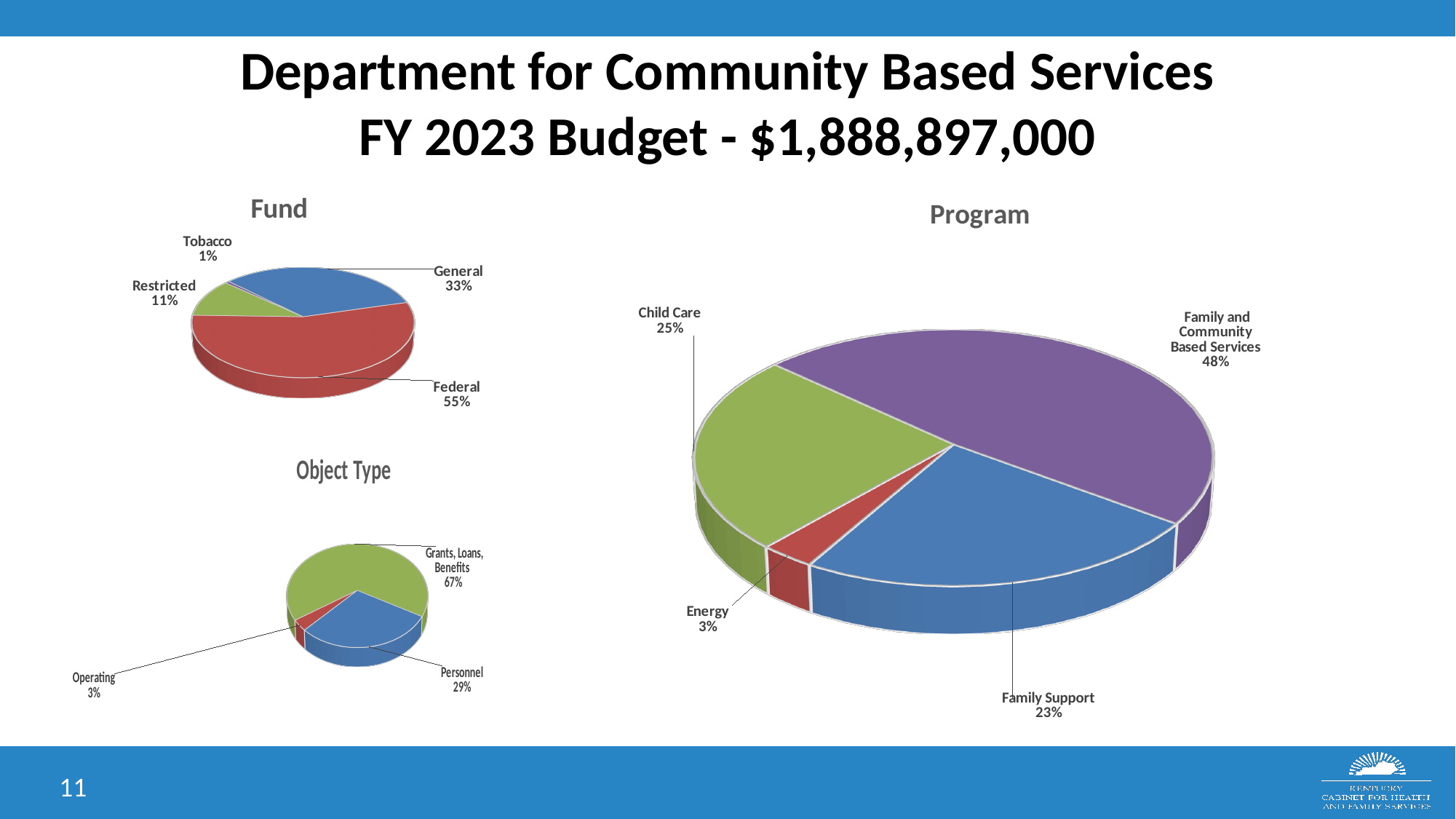
In the Program chart, what share is Child Care? 25% What type of chart is the Program chart? Pie chart In the Object Type chart, what share is Personnel? 29% In the Fund chart, what share of the budget comes from Federal funds? 55% In the Program chart, what is the difference in percentage points between Child Care and Family Support? 2 How many slices does the Fund pie chart have? 4 In the Fund chart, which fund source has the smallest share? Tobacco How many slices does the Program pie chart have? 4 In the Program chart, which program has the largest share? Family and Community Based Services In the Object Type chart, which is larger, Operating or Personnel? Personnel In the Object Type chart, which object type has the largest share? Grants, Loans, Benefits In the Fund chart, what is the difference in percentage points between the Federal and General shares? 22